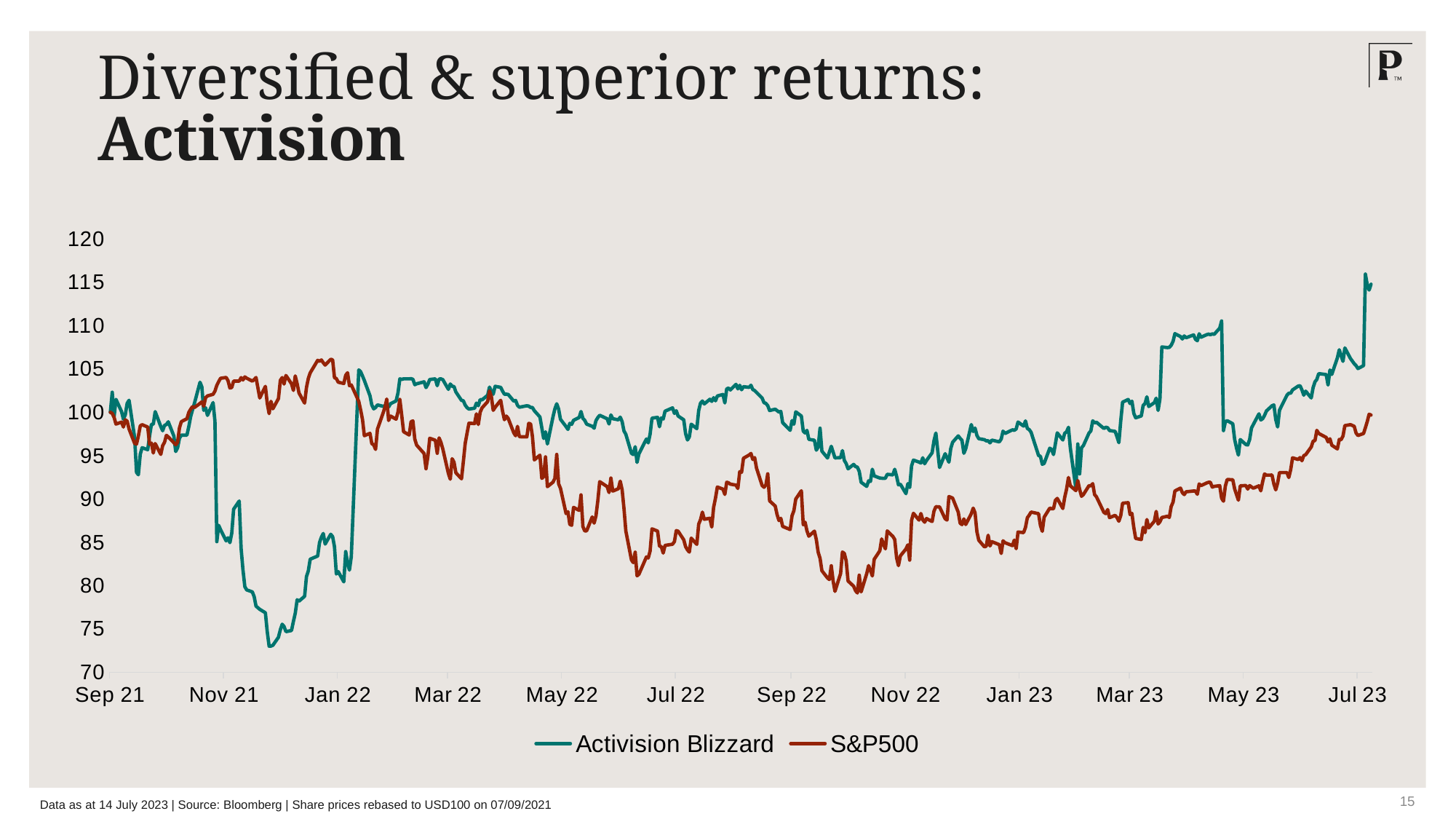
How many series does the legend list? 2 Which series is drawn in the teal/green colour? Activision Blizzard At Jan 22, which series has the higher value, Activision Blizzard or S&P500? S&P500 What kind of chart is shown on the slide? Line chart Is the value for S&P500 at Jan 22 greater or less than 100? greater Which series reaches the lowest point on the chart? Activision Blizzard Is the value for Activision Blizzard in mid-December 2021 greater or less than 80? less What are the two series named in the legend? Activision Blizzard and S&P500 Does the S&P500 line rise or fall between Jan 22 and Jul 22? Fall At Jul 23, which series has the higher value, Activision Blizzard or S&P500? Activision Blizzard Is the value for S&P500 in mid-October 2022 greater or less than 85? less